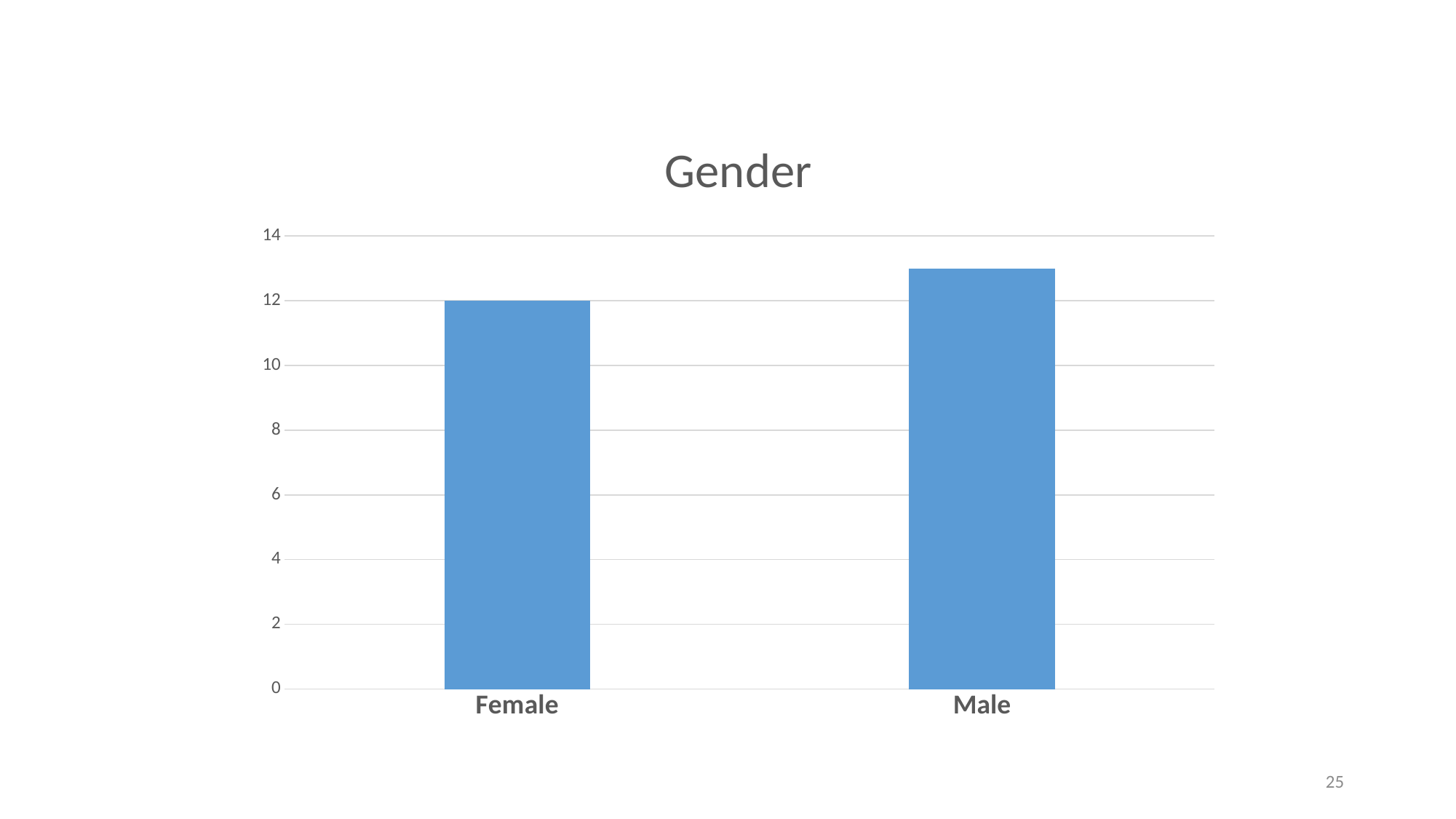
Is the value for Male greater or less than 14? less What is the highest value shown on the vertical axis? 14 Which is larger, the value for Female or the value for Male? Male Which category has the highest value? Male Is the value for Male greater or less than 12? greater What is the value for Female? 12 Which category has the lowest value? Female Is the value for Female greater or less than 10? greater What is the title of the chart? Gender What kind of chart is shown on the slide? Bar chart How many categories are shown on the x axis? 2